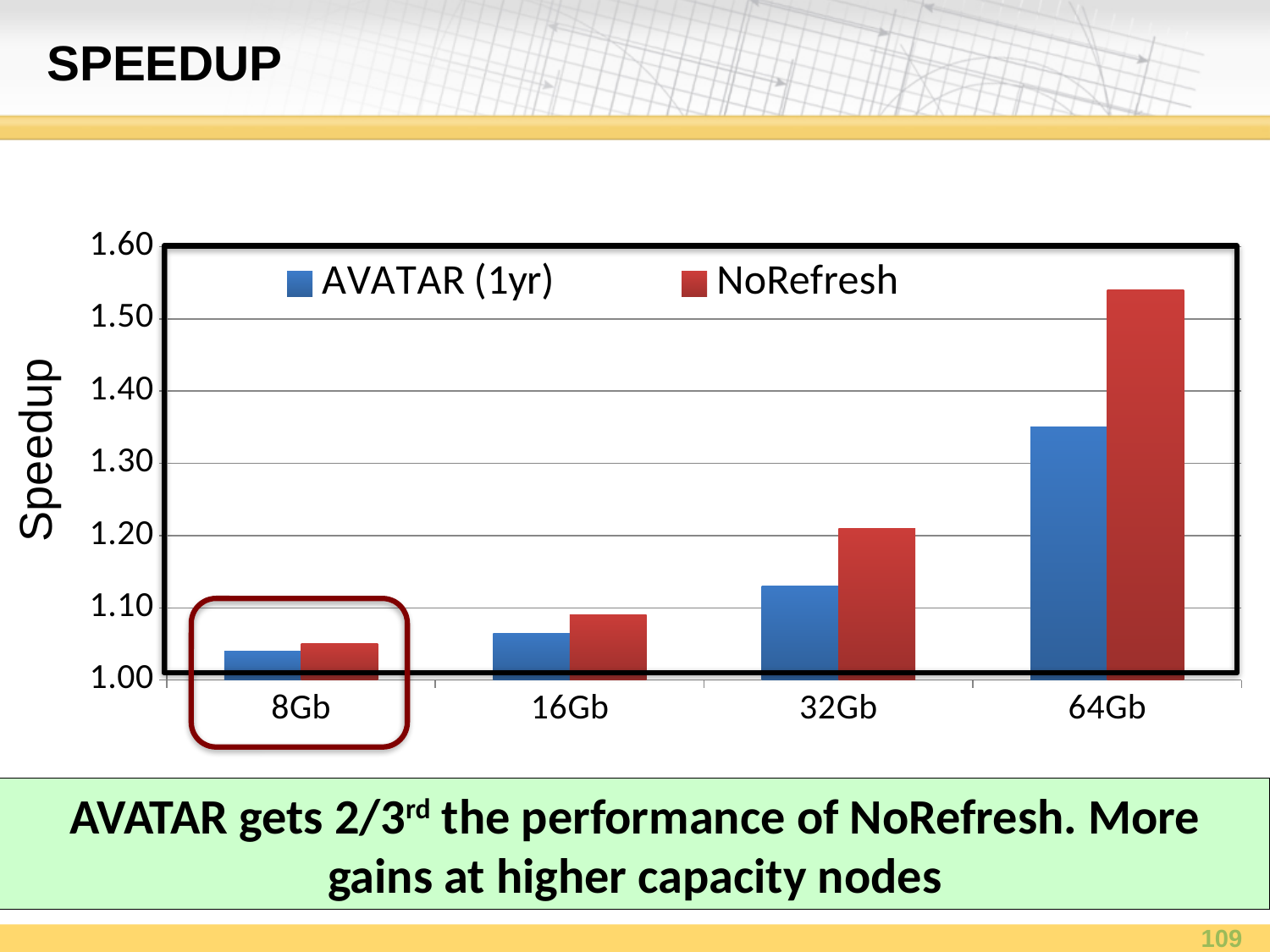
What kind of chart is shown on the slide? bar chart Is the AVATAR (1yr) speedup at 64Gb greater or less than 1.30? greater For which capacity is the NoRefresh speedup highest? 64Gb For which capacity is the AVATAR (1yr) speedup lowest? 8Gb What is the label on the y axis of the chart? Speedup Is the NoRefresh speedup at 32Gb greater or less than 1.30? less Is the AVATAR (1yr) speedup at 16Gb greater or less than 1.10? less How many capacity categories are shown on the x axis? 4 How many series does the legend list? 2 At 64Gb, which series has the larger speedup, AVATAR (1yr) or NoRefresh? NoRefresh Do the speedup values rise or fall as capacity increases from 8Gb to 64Gb? rise